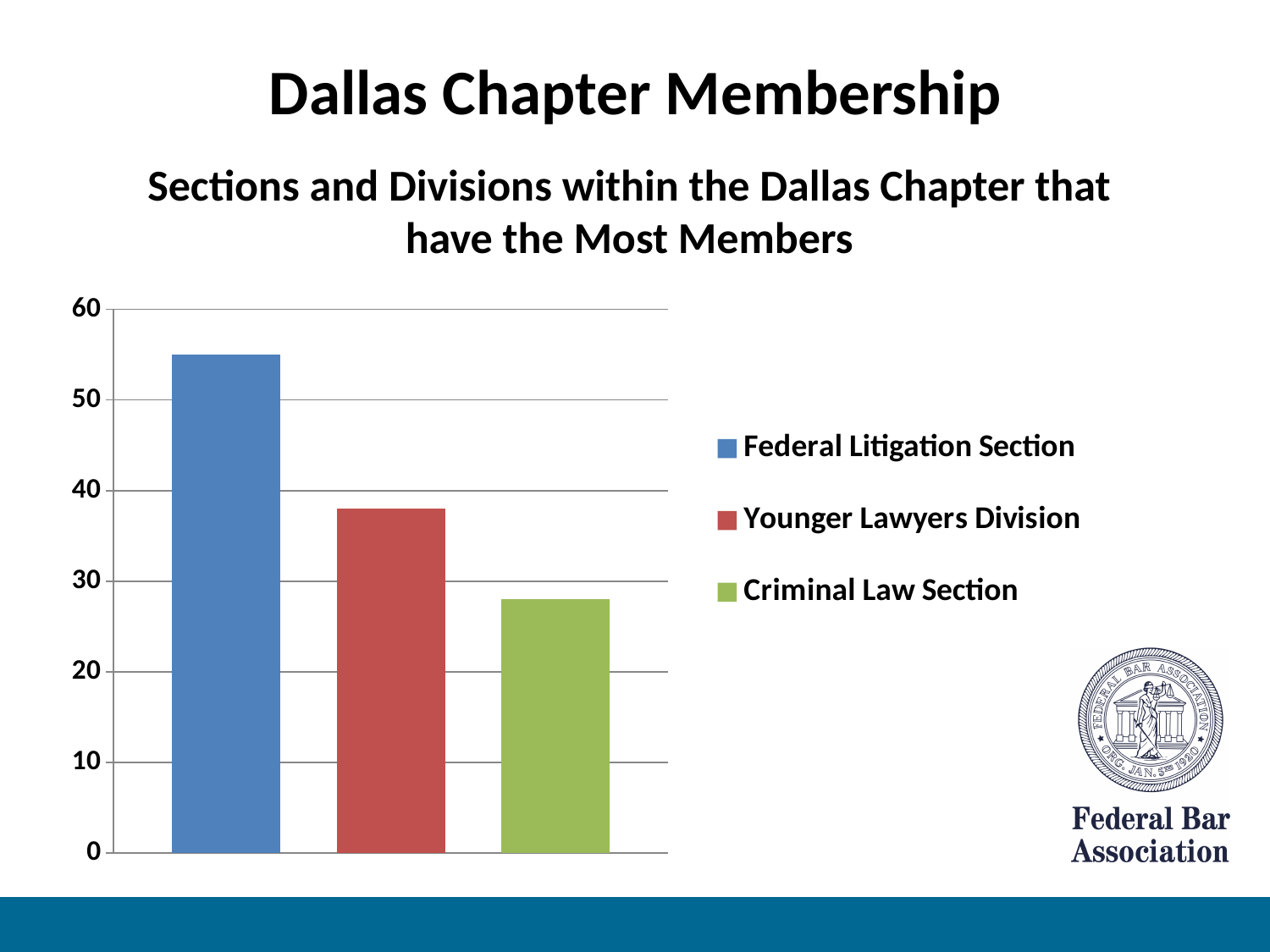
Is the value for the Criminal Law Section greater or less than 20? greater Is the value for the Criminal Law Section greater or less than 30? less Which section or division has the lowest membership in the chart? Criminal Law Section Which section or division has the highest membership in the chart? Federal Litigation Section Is the value for the Younger Lawyers Division greater or less than 40? less Which has more members, the Federal Litigation Section or the Younger Lawyers Division? Federal Litigation Section Which has more members, the Younger Lawyers Division or the Criminal Law Section? Younger Lawyers Division What colour is the bar for the Criminal Law Section? green What kind of chart is shown on the slide? bar chart How many bars are plotted in the chart? 3 How many entries does the legend list? 3